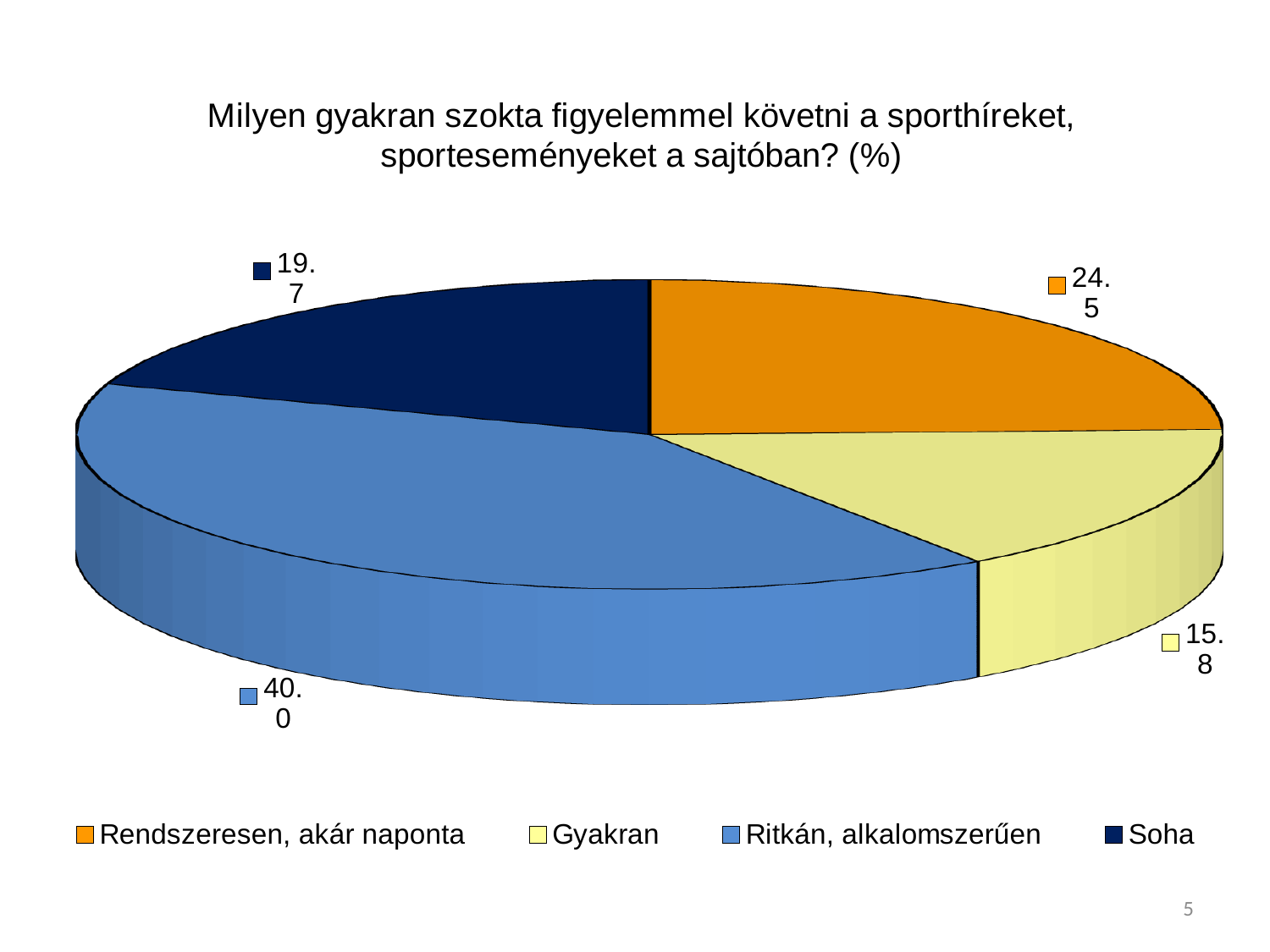
Which category has the smallest share of the pie? Gyakran Which is larger, the value for "Soha" or the value for "Gyakran"? Soha What is the value for "Soha"? 19.7 How many slices does the pie chart have? 4 What is the value for "Gyakran"? 15.8 What is the value for "Ritkán, alkalomszerűen"? 40.0 What is the difference between the values for "Ritkán, alkalomszerűen" and "Rendszeresen, akár naponta"? 15.5 How many entries does the legend list? 4 What type of chart is shown on the slide? Pie chart Which category has the largest share of the pie? Ritkán, alkalomszerűen What is the value for "Rendszeresen, akár naponta"? 24.5 What colour is the slice for "Soha"? Dark blue